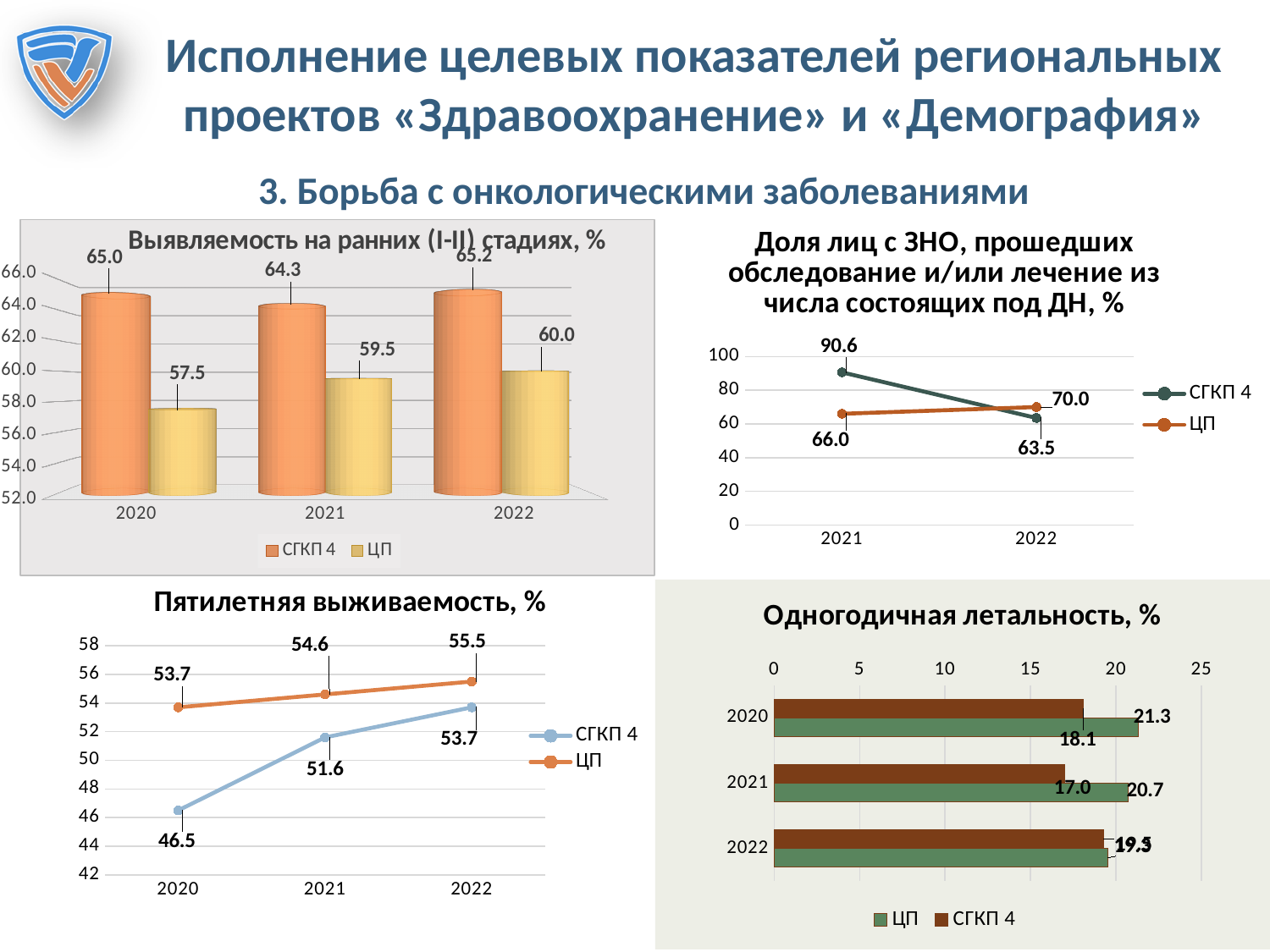
What kind of chart is 'Одногодичная летальность, %'? bar chart In the chart 'Пятилетняя выживаемость, %', what is the difference between ЦП and СГКП 4 in 2021? 3.0 In the chart 'Одногодичная летальность, %', what is the value for ЦП in 2021? 20.7 In the chart 'Пятилетняя выживаемость, %', what is the value for СГКП 4 in 2020? 46.5 In the chart 'Выявляемость на ранних (I-II) стадиях, %', in which year is the ЦП value lowest? 2020 In the chart 'Пятилетняя выживаемость, %', how many years are shown on the x axis? 3 In the chart 'Доля лиц с ЗНО, прошедших обследование и/или лечение из числа состоящих под ДН, %', does the СГКП 4 line rise or fall from 2021 to 2022? fall In the chart 'Доля лиц с ЗНО, прошедших обследование и/или лечение из числа состоящих под ДН, %', which is larger in 2022, СГКП 4 or ЦП? ЦП In the chart 'Выявляемость на ранних (I-II) стадиях, %', what is the value for ЦП in 2020? 57.5 In the chart 'Выявляемость на ранних (I-II) стадиях, %', what is the difference between СГКП 4 and ЦП in 2022? 5.2 In the chart 'Доля лиц с ЗНО, прошедших обследование и/или лечение из числа состоящих под ДН, %', what is the value for СГКП 4 in 2021? 90.6 In the chart 'Выявляемость на ранних (I-II) стадиях, %', what is the value for СГКП 4 in 2021? 64.3